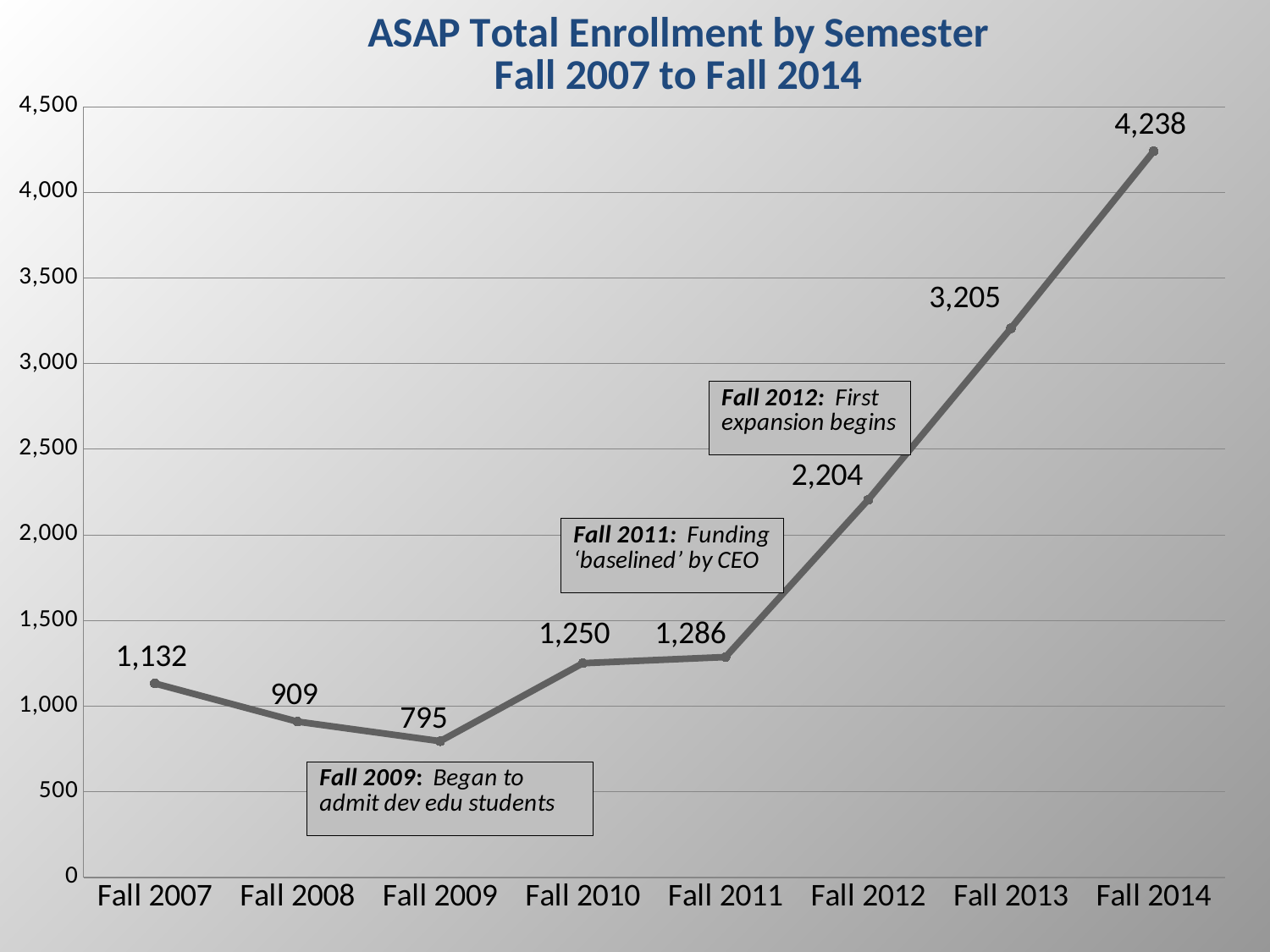
What was the ASAP total enrollment in Fall 2007? 1,132 What was the ASAP total enrollment in Fall 2014? 4,238 What kind of chart is shown on the slide? Line chart Which semester had the highest enrollment? Fall 2014 What is the difference in enrollment between Fall 2014 and Fall 2013? 1,033 How many semesters are plotted on the chart? 8 Does enrollment rise or fall from Fall 2009 to Fall 2014? Rise What was the ASAP total enrollment in Fall 2012? 2,204 Which semester had higher enrollment, Fall 2010 or Fall 2011? Fall 2011 Which semester had the lowest enrollment? Fall 2009 According to the annotation on the chart, what happened in Fall 2012? First expansion begins What is the difference in enrollment between Fall 2007 and Fall 2009? 337